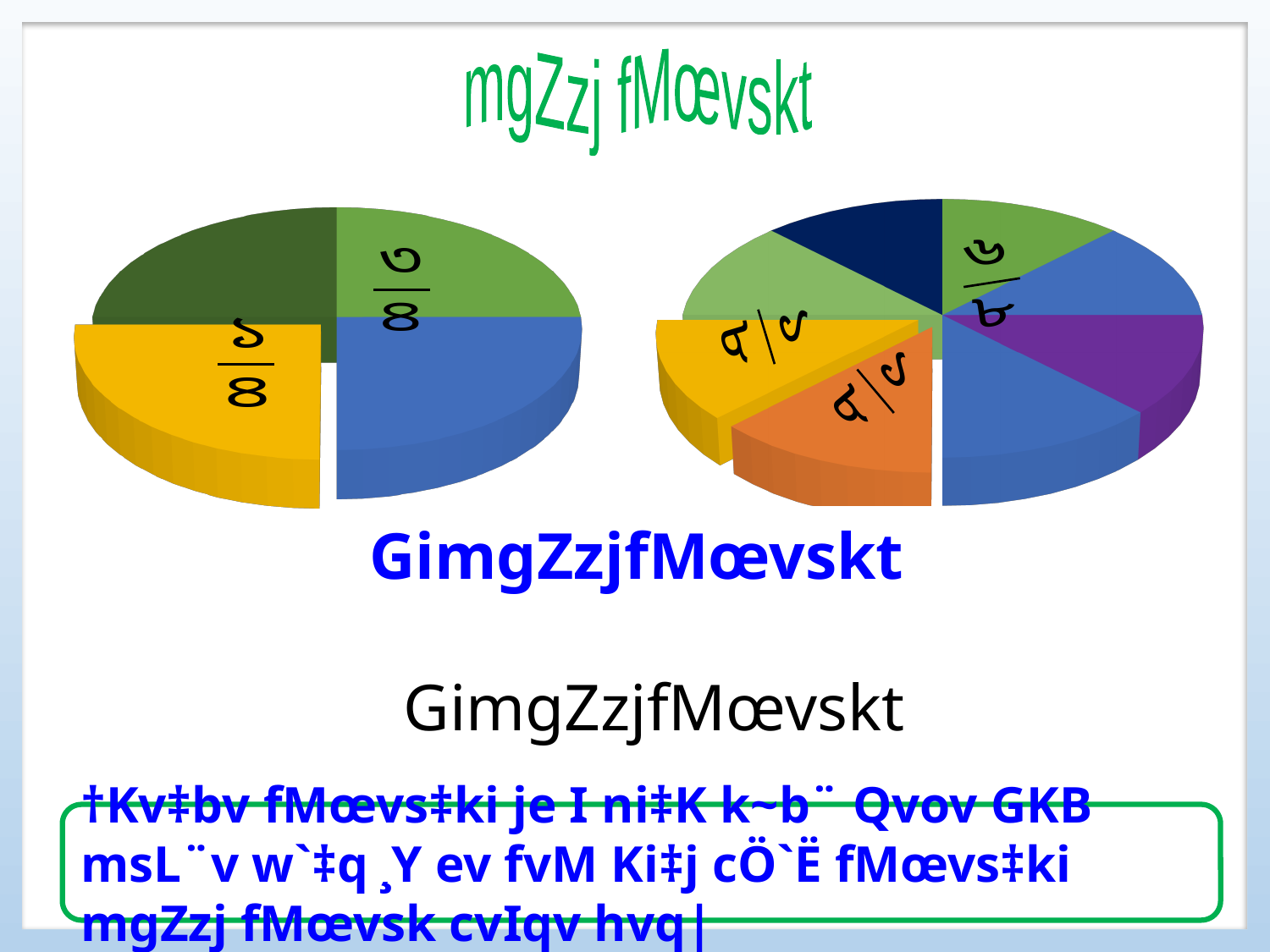
In the pie chart on the right, what label is printed on the orange slice? ১/৮ In the pie chart on the left, what label is printed on the yellow slice? ১/৪ What kind of chart is the chart on the right side of the slide? pie chart How many slices are pulled out (exploded) from the pie chart on the left? 1 In the pie chart on the right, what label is printed on the green slice at the top? ৬/৮ What kind of chart is the chart on the left side of the slide? pie chart How many slices are pulled out (exploded) from the pie chart on the right? 2 In the pie chart on the right, what label is printed on the yellow slice? ১/৮ In the pie chart on the left, what label is printed on the light green slice? ৩/৪ How many slices does the pie chart on the right have? 8 How many slices does the pie chart on the left have? 4 How many charts are shown on the slide? 2